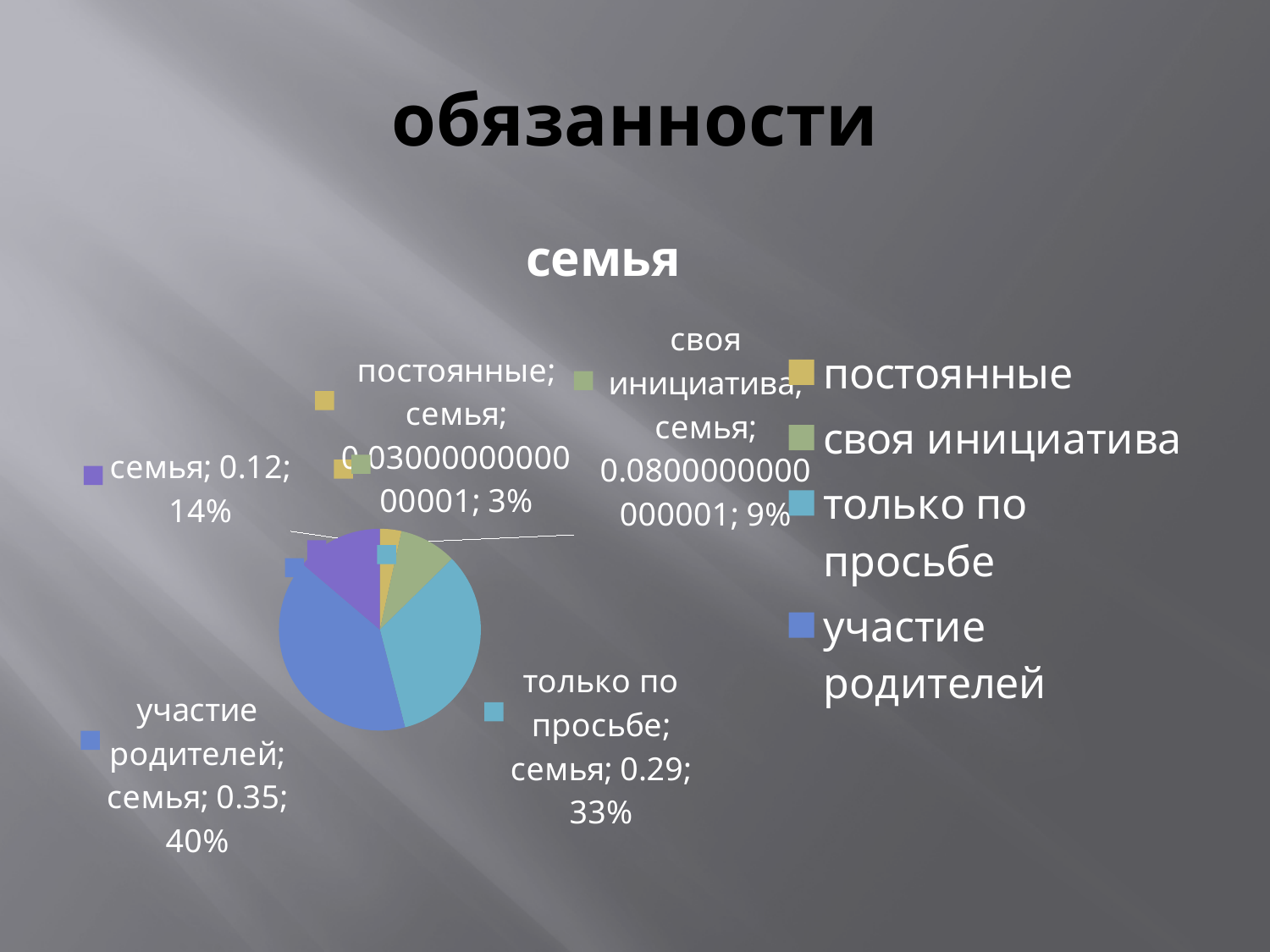
Which slice of the pie is the largest? участие родителей What percentage share does the slice 'участие родителей' have? 40% What percentage share does the slice 'своя инициатива' have? 9% What is the title of the chart? семья What value is printed for 'только по просьбе' in the data label? 0.29 Which slice is larger: 'своя инициатива' or 'постоянные'? своя инициатива What percentage share does the slice 'только по просьбе' have? 33% What kind of chart is shown on the slide? pie chart How many slices does the pie chart have? 5 Which slice of the pie is the smallest? постоянные How many entries does the chart's legend list? 4